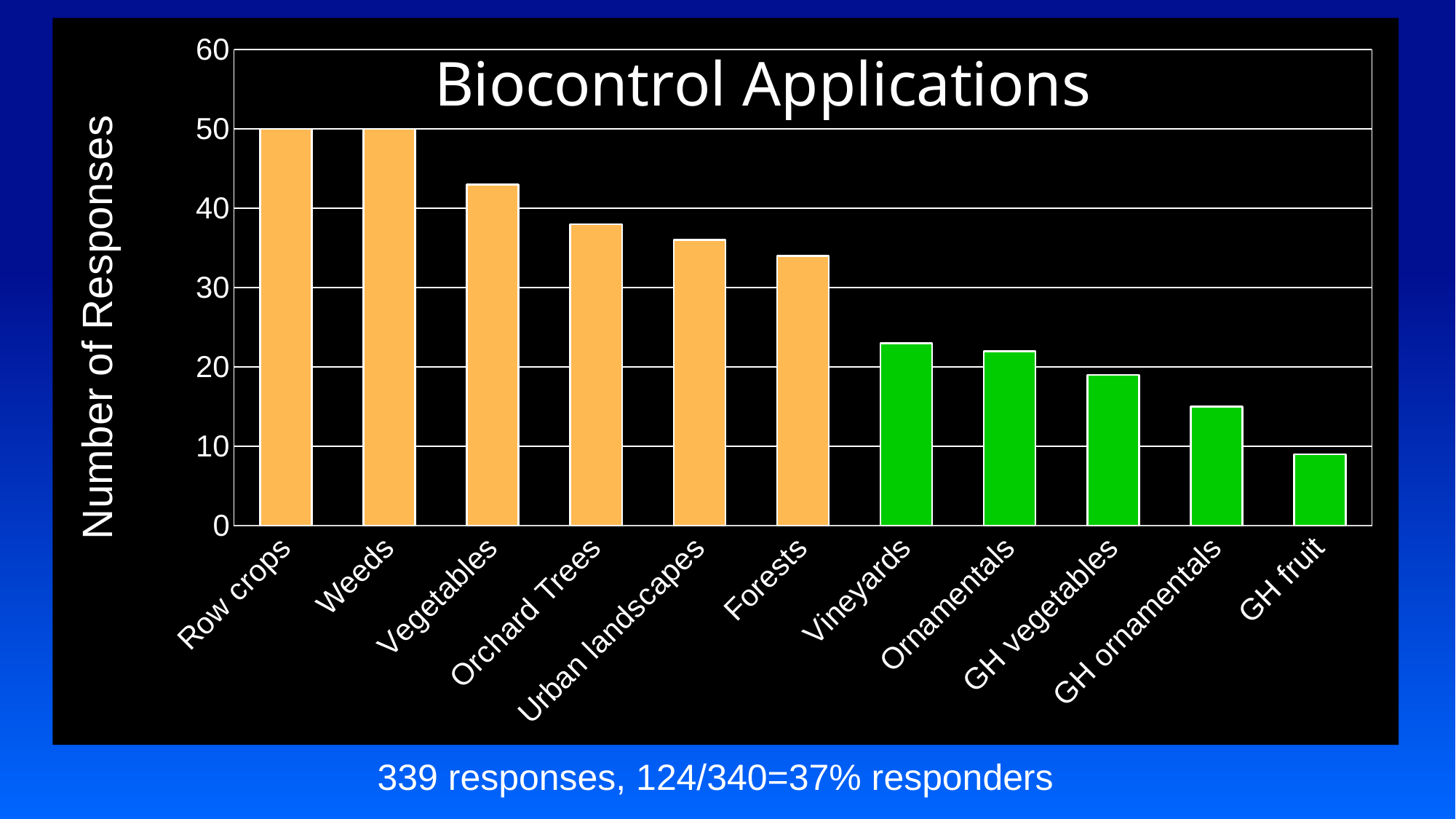
What is the value for Row crops? 50 Do the values rise or fall from left to right along the x axis? Fall Which category has the lowest number of responses? GH fruit Is the value for Vegetables greater or less than 40? greater How many categories are shown on the x axis? 11 Which has more responses, Vegetables or Orchard Trees? Vegetables Is the value for Forests greater or less than 30? greater Is the value for GH ornamentals greater or less than 20? less What kind of chart is this? Bar chart What is the title of the chart? Biocontrol Applications What is the value for Weeds? 50